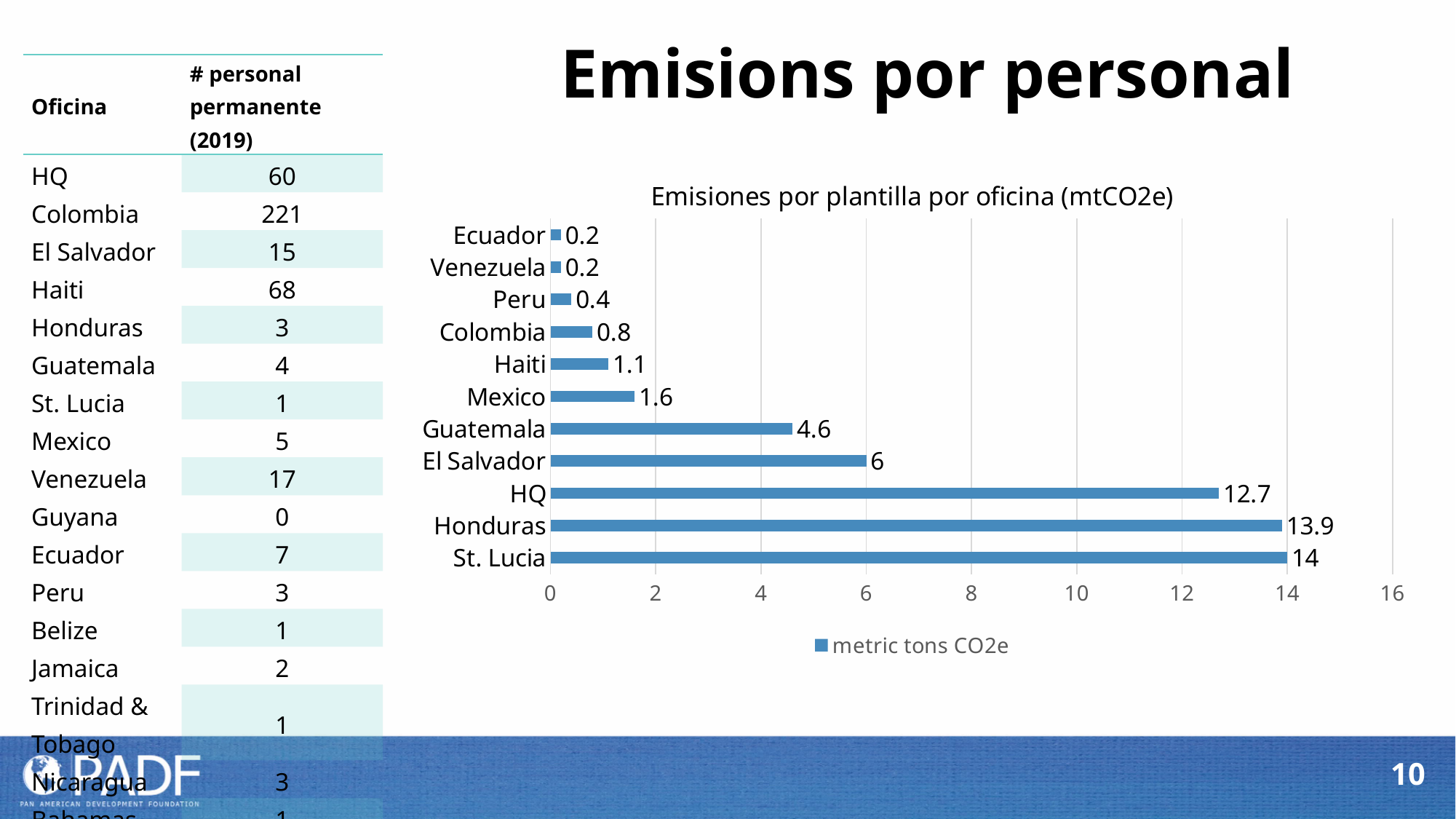
What is the value for Guatemala in the chart? 4.6 Which office has the highest emissions per staff in the chart? St. Lucia Which is larger, the value for Guatemala or the value for Colombia? Guatemala What kind of chart is shown on the slide? bar chart Is the value for El Salvador greater or less than 4? greater What is the difference between the values for El Salvador and Mexico? 4.4 What is the difference between the values for Honduras and HQ? 1.2 What is the value for Haiti in the chart? 1.1 How many series does the chart legend list? 1 How many offices are shown in the chart? 11 What is the value for HQ in the chart? 12.7 What is the title of the chart? Emisiones por plantilla por oficina (mtCO2e)